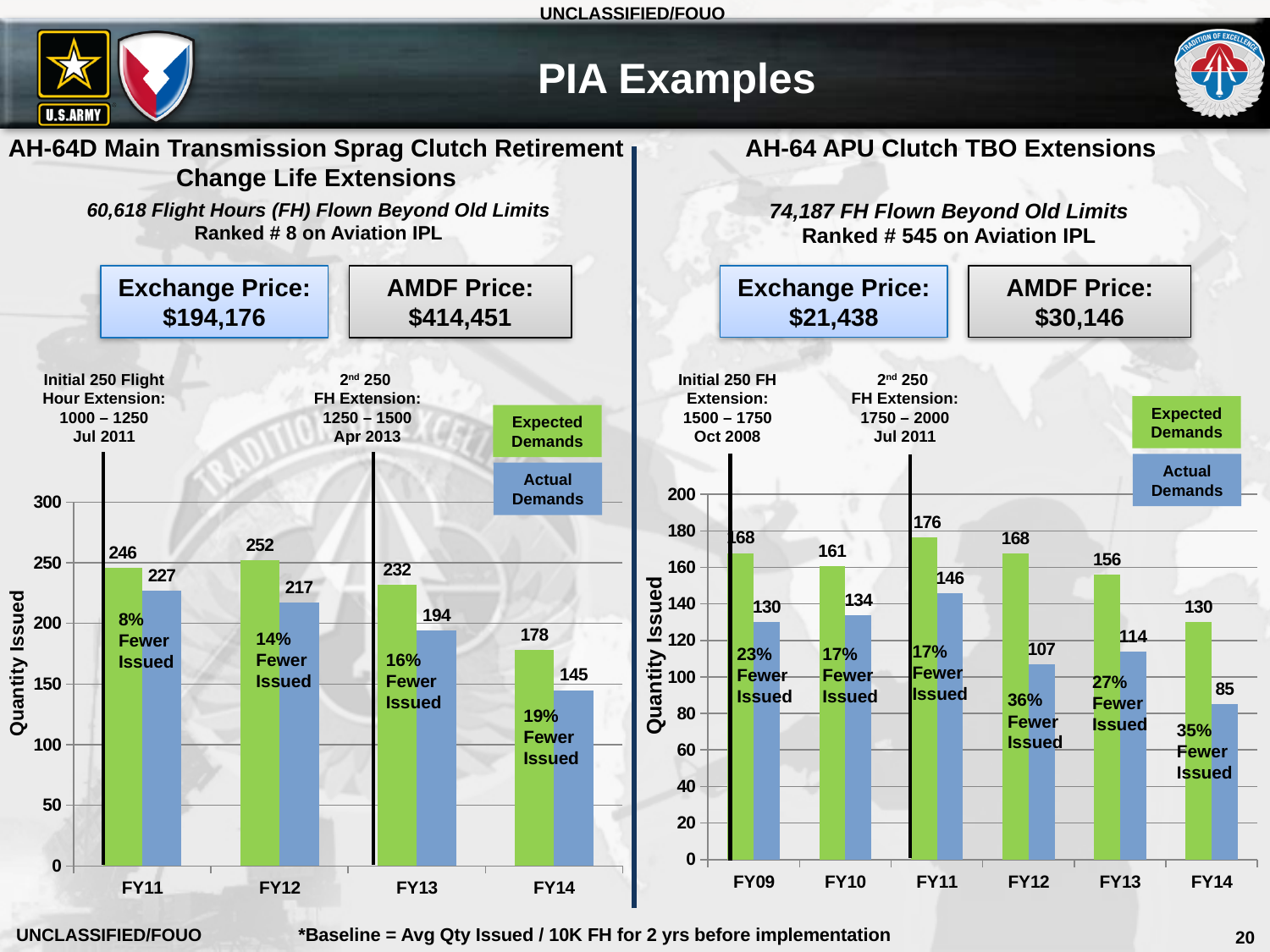
How many series does the legend list in the AH-64 APU Clutch TBO Extensions chart on the right? 2 In the AH-64 APU Clutch TBO Extensions chart on the right, what is the difference between Expected Demands and Actual Demands in FY14? 45 In the AH-64D Main Transmission Sprag Clutch chart on the left, how many fiscal years are shown on the x axis? 4 In the AH-64 APU Clutch TBO Extensions chart on the right, what is the Expected Demands value for FY11? 176 In the AH-64 APU Clutch TBO Extensions chart on the right, what is the Actual Demands value for FY12? 107 In the AH-64D Main Transmission Sprag Clutch chart on the left, which fiscal year has the highest Expected Demands? FY12 In the AH-64D Main Transmission Sprag Clutch chart on the left, what is the Expected Demands value for FY12? 252 What type of chart is the AH-64D Main Transmission Sprag Clutch chart on the left? Bar chart In the AH-64D Main Transmission Sprag Clutch chart on the left, what is the Actual Demands value for FY14? 145 In the AH-64 APU Clutch TBO Extensions chart on the right, which fiscal year has the lowest Actual Demands? FY14 In the AH-64 APU Clutch TBO Extensions chart on the right, is the Actual Demands value for FY10 larger or smaller than the Actual Demands value for FY09? larger In the AH-64D Main Transmission Sprag Clutch chart on the left, what is the difference between Expected Demands and Actual Demands in FY13? 38